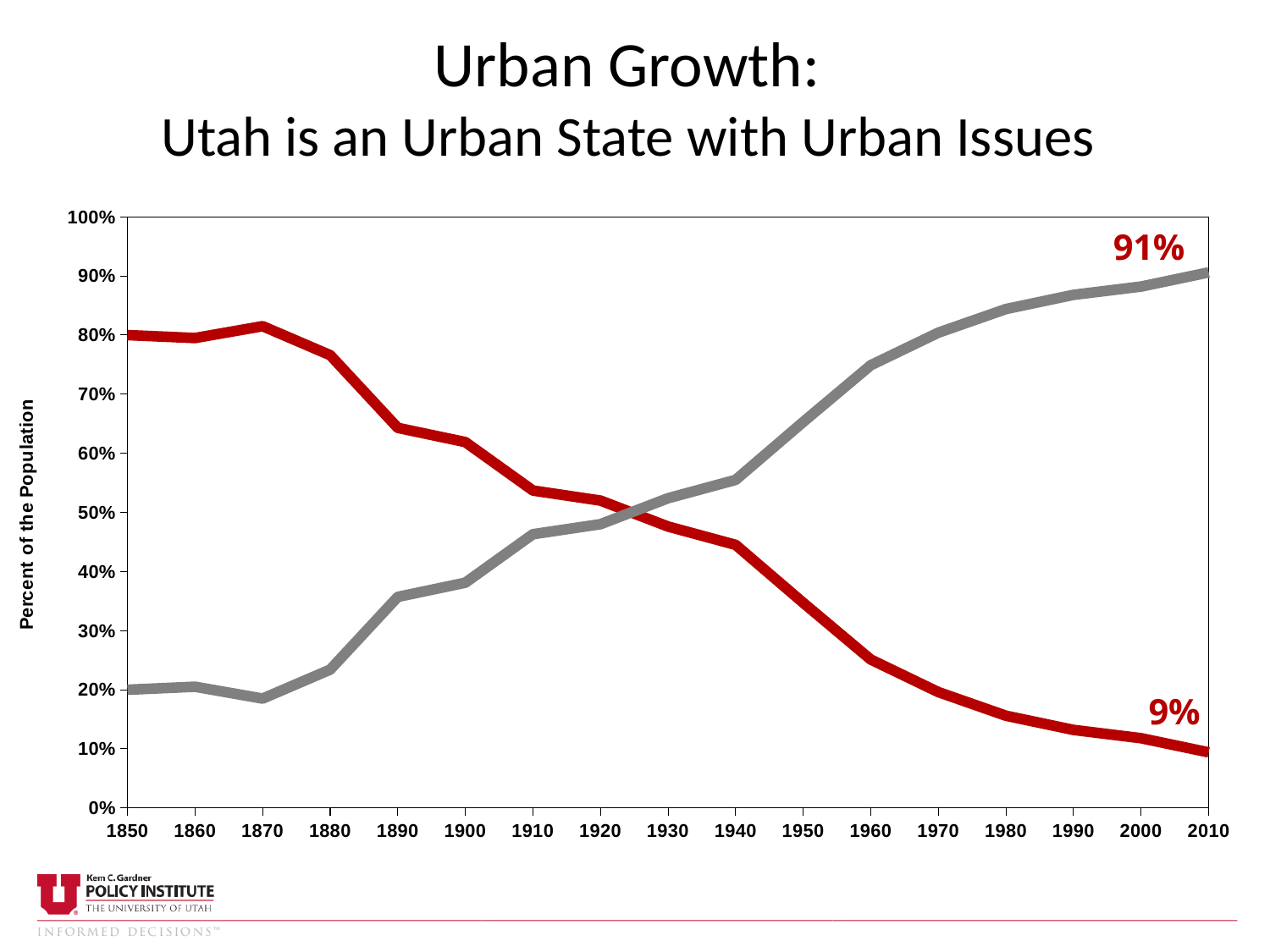
In 1900, which line has the higher value, the red line or the gray line? the red line How many years are labelled on the x axis? 17 What kind of chart is shown on the slide? line chart What is the difference between the gray line's value and the red line's value in 2010? 82% Is the value of the red line in 1960 greater or less than 30%? less Is the value of the gray line in 1850 greater or less than 30%? less Does the gray line rise or fall from 1850 to 2010? rise What value does the gray line reach in 2010? 91% Is the value of the red line in 1850 greater or less than 70%? greater What value does the red line reach in 2010? 9% Does the red line rise or fall from 1850 to 2010? fall What is the label on the y axis? Percent of the Population